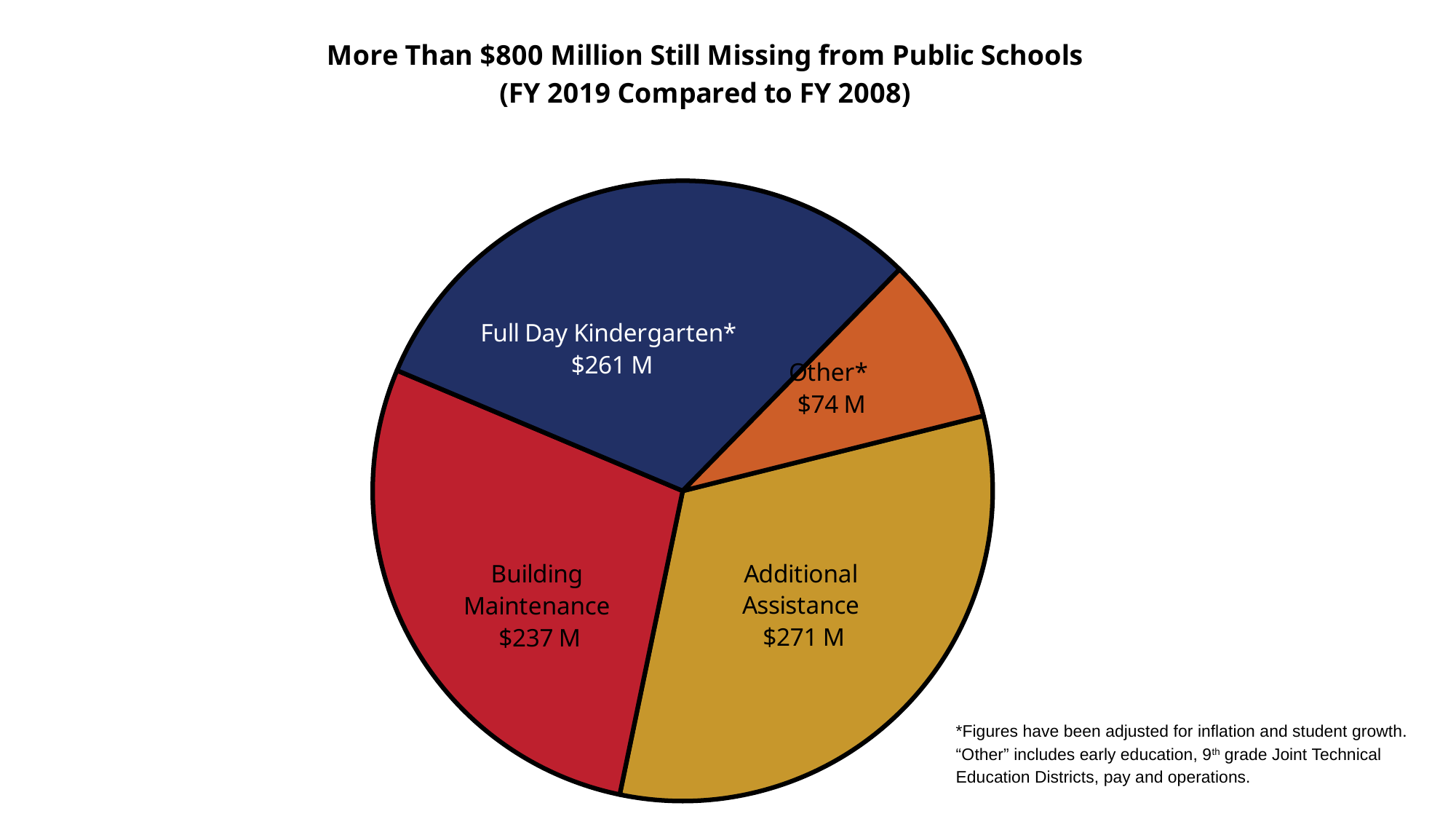
What is the title of the chart? More Than $800 Million Still Missing from Public Schools (FY 2019 Compared to FY 2008) What is the total of all four slices in the pie chart? $843 M What type of chart is shown on the slide? Pie chart Which category has the largest value? Additional Assistance What is the difference between Additional Assistance and Building Maintenance? $34 M What is the value for Other*? $74 M Which is larger, Full Day Kindergarten* or Building Maintenance? Full Day Kindergarten* What is the value for Building Maintenance? $237 M How many slices does the pie chart have? 4 Which category has the smallest value? Other* What is the value for Additional Assistance? $271 M What is the value for Full Day Kindergarten*? $261 M